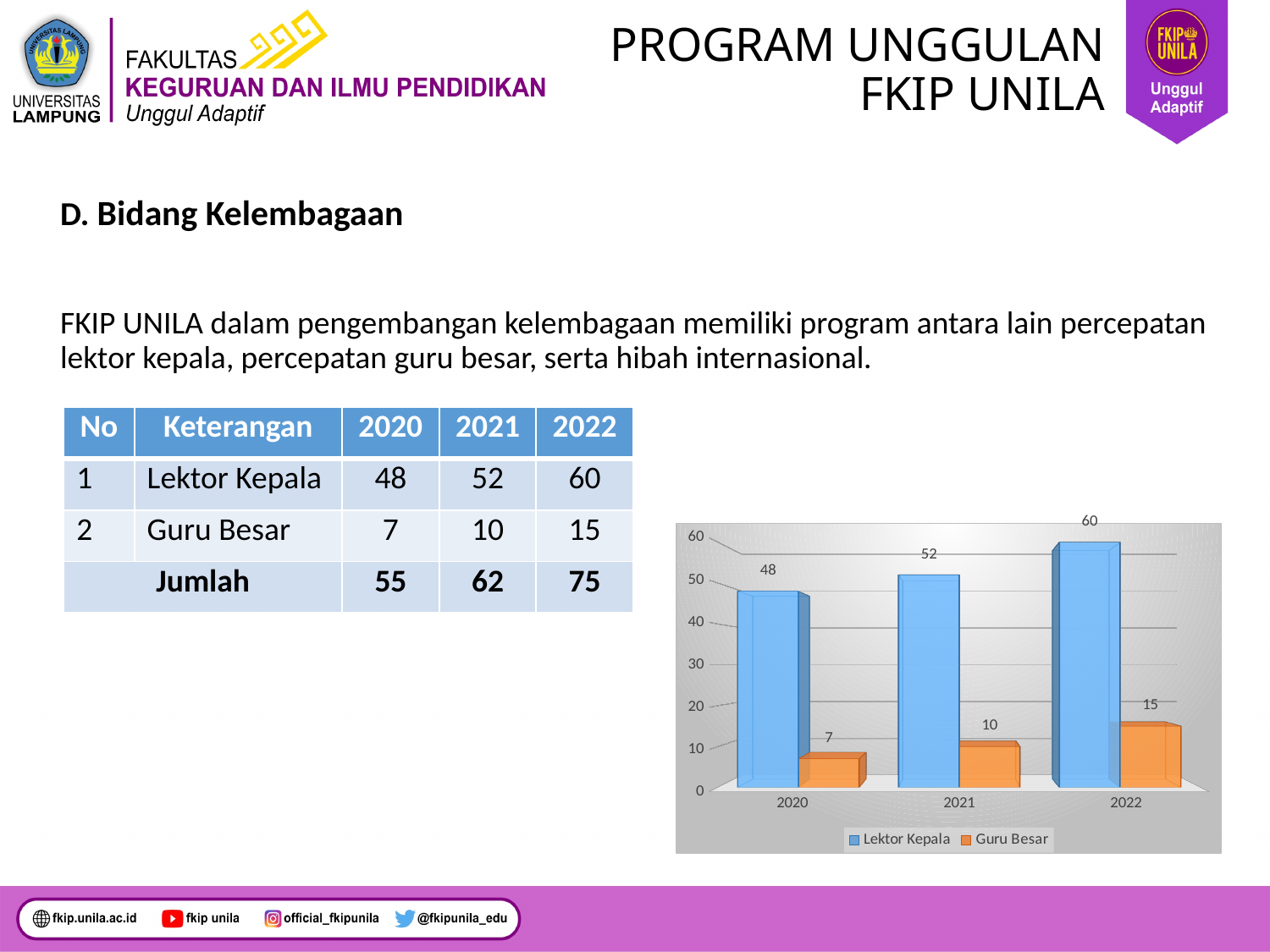
Which is larger: Guru Besar in 2021 or Guru Besar in 2022? Guru Besar in 2022 What is the value for Guru Besar in 2020? 7 How many series does the chart legend list? 2 What is the value for Lektor Kepala in 2021? 52 In which year is the Guru Besar value lowest? 2020 What is the value for Guru Besar in 2022? 15 What is the difference between the Lektor Kepala values for 2022 and 2020? 12 What kind of chart is shown on the slide? bar chart Is the value for Lektor Kepala in 2020 greater or less than 40? greater How many years are shown on the x axis of the chart? 3 In which year is the Lektor Kepala value highest? 2022 Do the Lektor Kepala values rise or fall from 2020 to 2022? rise